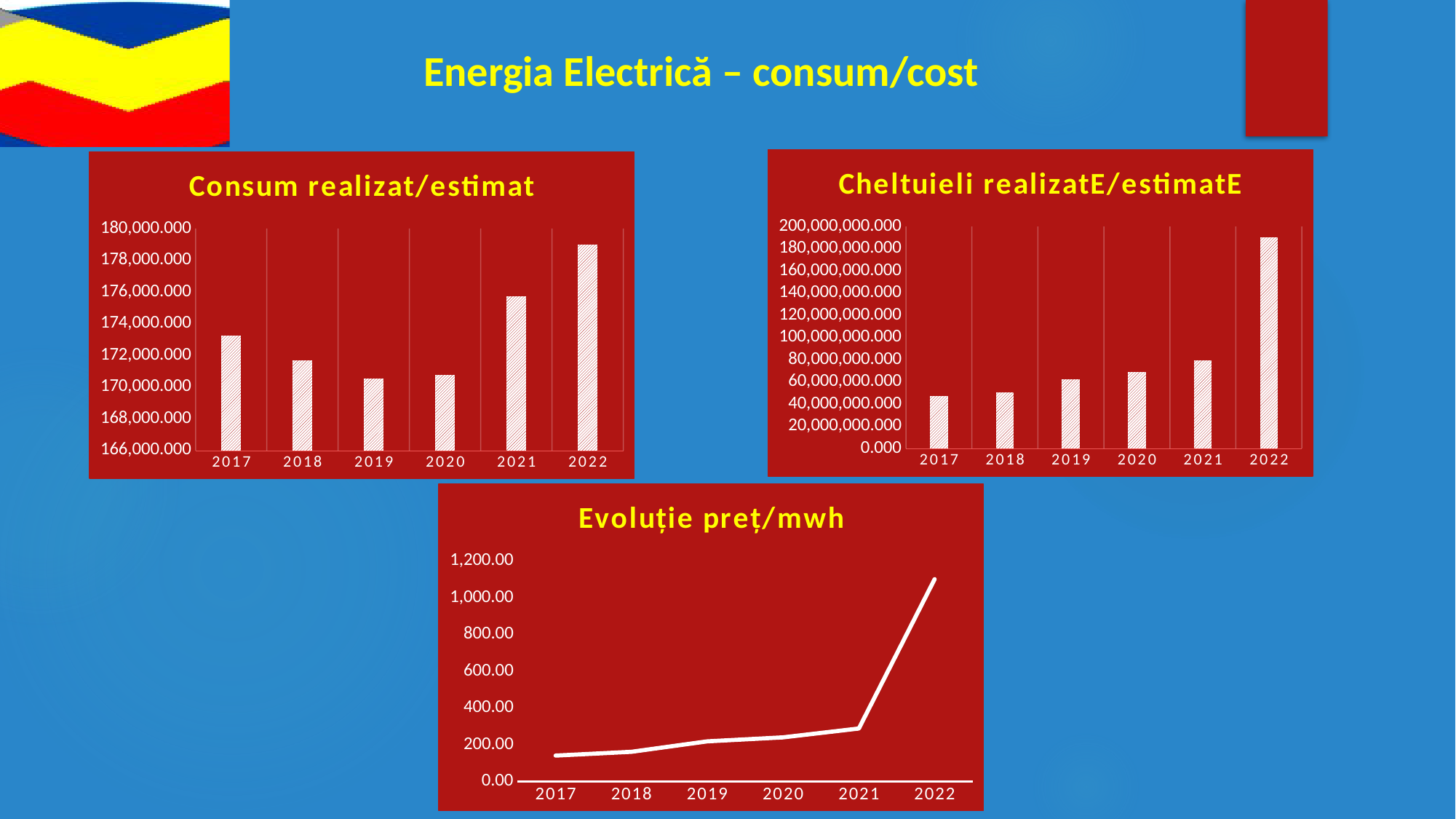
In the "Consum realizat/estimat" chart, is the value for 2019 greater or less than 172,000.000? less In the "Consum realizat/estimat" chart, which is larger, the value for 2017 or the value for 2018? 2017 What kind of chart is the "Evoluție preț/mwh" chart? line chart What kind of chart is the "Consum realizat/estimat" chart? bar chart In the "Consum realizat/estimat" chart, is the value for 2022 greater or less than 178,000.000? greater In the "Evoluție preț/mwh" chart, is the value for 2022 greater or less than 1,000.00? greater In the "Cheltuieli realizatE/estimatE" chart, which year has the highest value? 2022 How many years are shown on the x axis of the "Cheltuieli realizatE/estimatE" chart? 6 In the "Consum realizat/estimat" chart, which year has the highest value? 2022 In the "Cheltuieli realizatE/estimatE" chart, do the values rise or fall from 2017 to 2022? rise